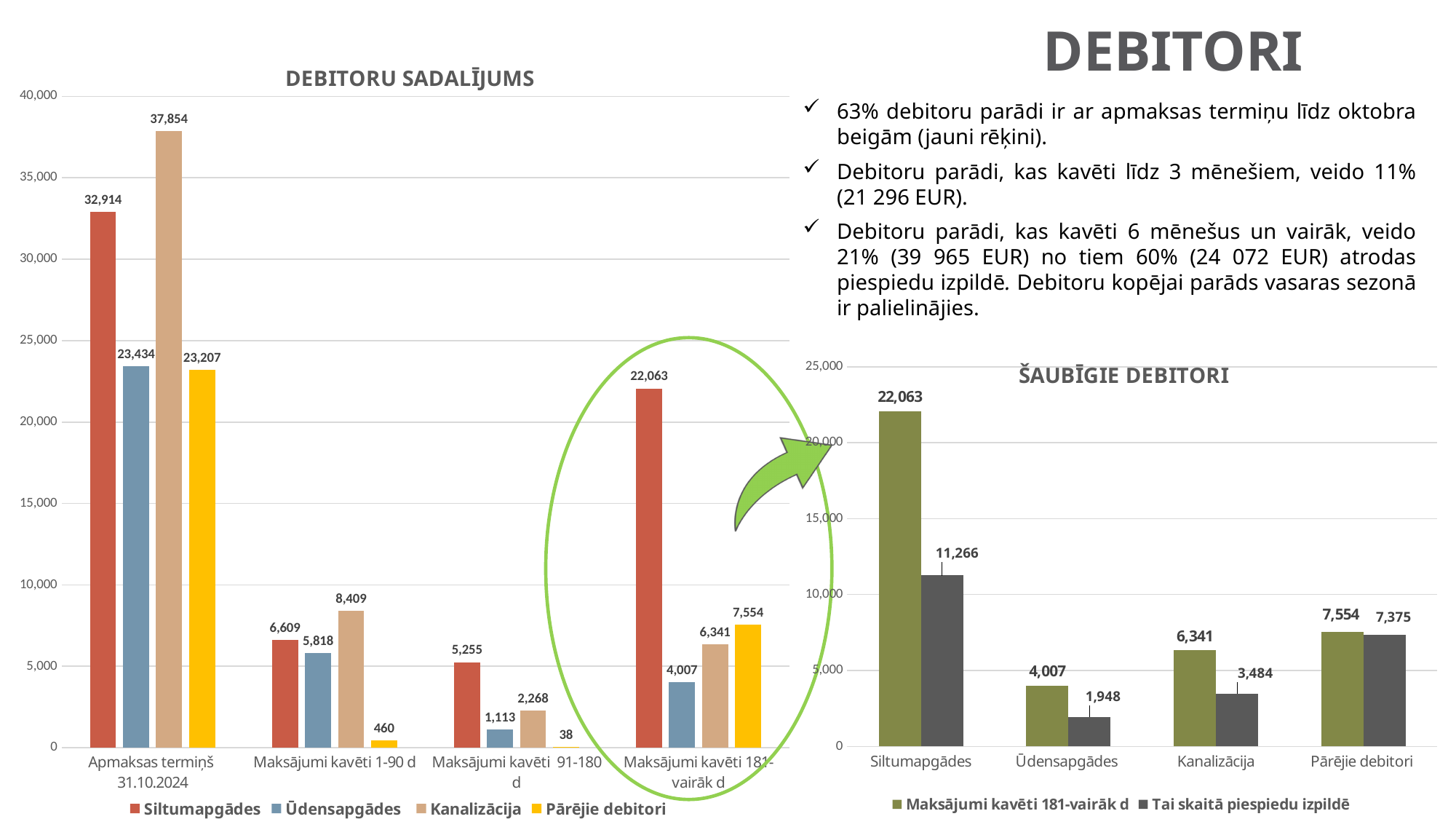
What kind of chart is ŠAUBĪGIE DEBITORI? Bar chart In the DEBITORU SADALĪJUMS chart, what is the value for Kanalizācija in the Apmaksas termiņš 31.10.2024 category? 37,854 In the DEBITORU SADALĪJUMS chart, what is the difference between Kanalizācija and Siltumapgādes in the Apmaksas termiņš 31.10.2024 category? 4,940 In the ŠAUBĪGIE DEBITORI chart, how many series does the legend list? 2 In the ŠAUBĪGIE DEBITORI chart, which is larger for Ūdensapgādes: Maksājumi kavēti 181-vairāk d or Tai skaitā piespiedu izpildē? Maksājumi kavēti 181-vairāk d In the DEBITORU SADALĪJUMS chart, which series has the highest value in the Apmaksas termiņš 31.10.2024 category? Kanalizācija In the DEBITORU SADALĪJUMS chart, which series has the lowest value in the Maksājumi kavēti 91-180 d category? Pārējie debitori In the DEBITORU SADALĪJUMS chart, what is the value for Siltumapgādes in the Maksājumi kavēti 181-vairāk d category? 22,063 In the DEBITORU SADALĪJUMS chart, how many series does the legend list? 4 In the ŠAUBĪGIE DEBITORI chart, what is the value of Tai skaitā piespiedu izpildē for Siltumapgādes? 11,266 In the ŠAUBĪGIE DEBITORI chart, what is the difference between Maksājumi kavēti 181-vairāk d and Tai skaitā piespiedu izpildē for Kanalizācija? 2,857 In the DEBITORU SADALĪJUMS chart, how many categories are shown on the x axis? 4